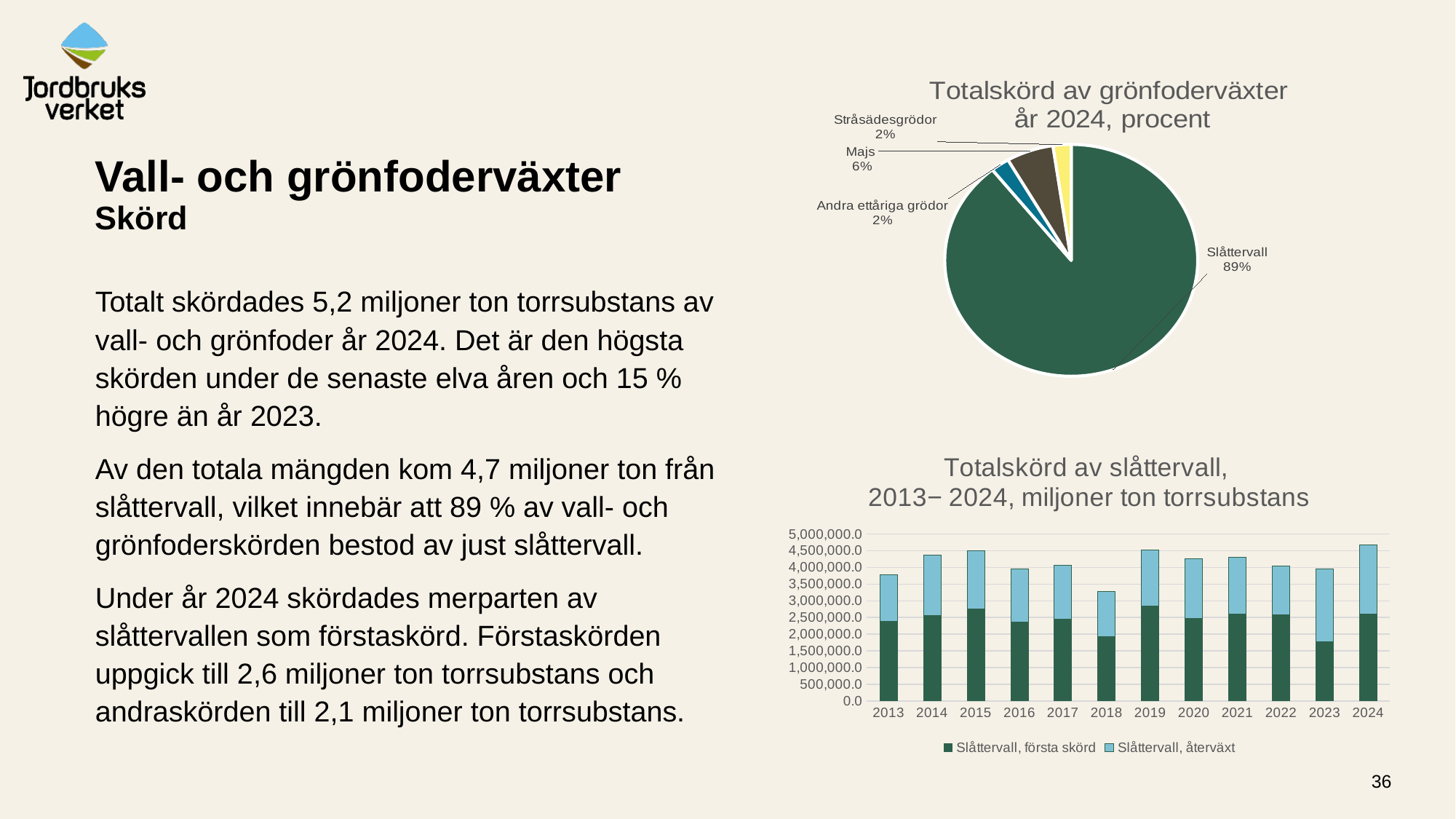
How many slices does the pie chart 'Totalskörd av grönfoderväxter år 2024, procent' have? 4 In the chart 'Totalskörd av slåttervall, 2013−2024', which series does the dark green segment represent? Slåttervall, första skörd In the chart 'Totalskörd av slåttervall, 2013−2024', which year has the lowest total bar? 2018 What kind of chart is the upper chart on the slide, 'Totalskörd av grönfoderväxter år 2024, procent'? Pie chart In the pie chart 'Totalskörd av grönfoderväxter år 2024, procent', what share does Majs have? 6% How many series does the legend of the chart 'Totalskörd av slåttervall, 2013−2024' list? 2 How many years are shown on the x axis of the chart 'Totalskörd av slåttervall, 2013−2024'? 12 In the chart 'Totalskörd av slåttervall, 2013−2024', is the total bar for 2018 greater or less than 3,500,000? less In the pie chart 'Totalskörd av grönfoderväxter år 2024, procent', what share does Slåttervall have? 89% In the chart 'Totalskörd av slåttervall, 2013−2024', is the total bar for 2024 greater or less than 4,500,000? greater In the pie chart 'Totalskörd av grönfoderväxter år 2024, procent', which category has the largest slice? Slåttervall What kind of chart is the lower chart on the slide, 'Totalskörd av slåttervall, 2013−2024'? Stacked bar chart